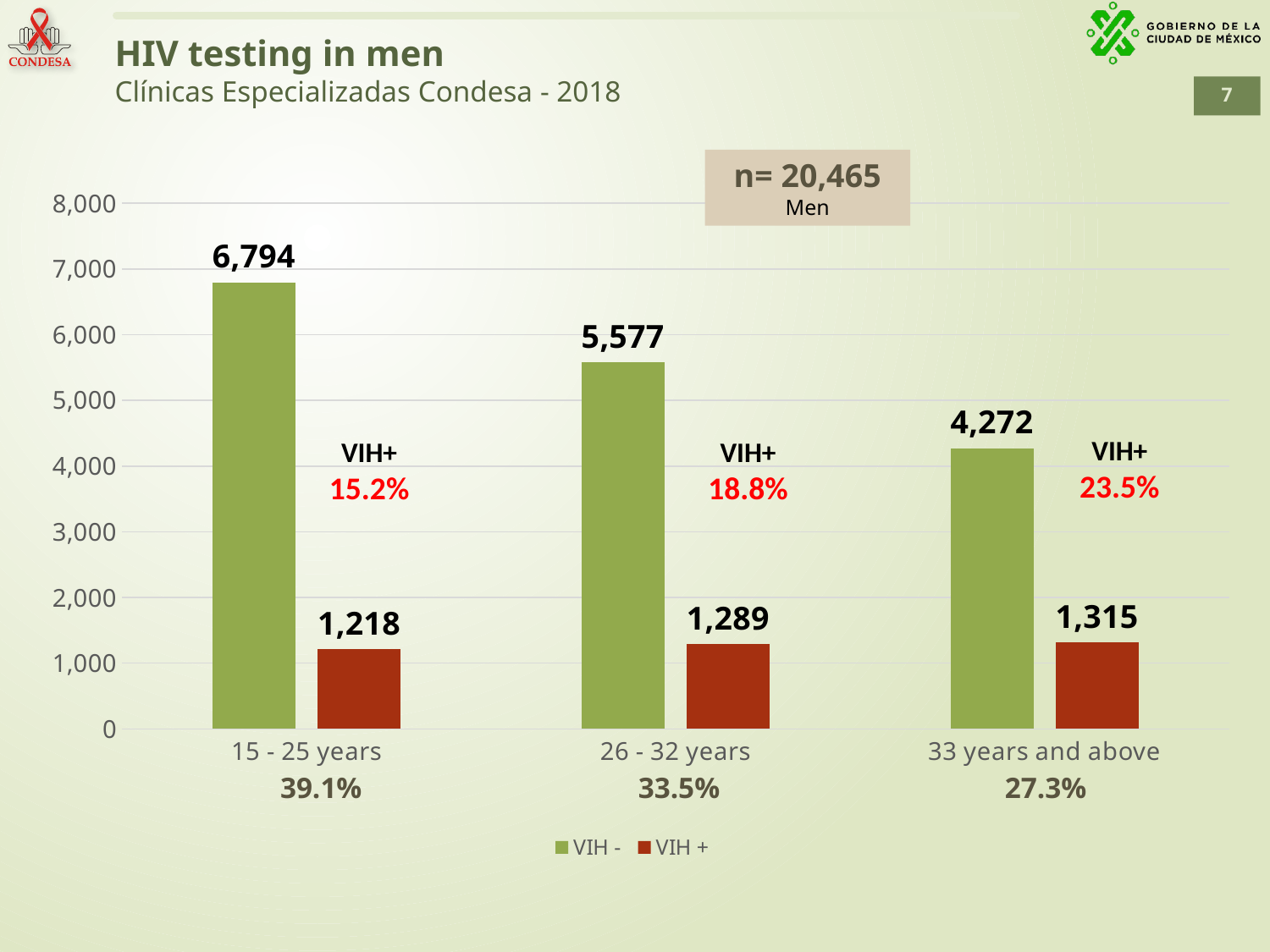
Do the VIH - values rise or fall from the youngest to the oldest age group? fall How many age groups are shown on the x axis? 3 What is the VIH + value for the 26 - 32 years group? 1,289 What kind of chart is shown on the slide? bar chart Which age group has the lowest VIH + value? 15 - 25 years Is the VIH - value for 26 - 32 years greater or less than 5,000? greater Which is larger: the VIH + value for 33 years and above or the VIH + value for 15 - 25 years? 33 years and above What is the VIH - value for the 33 years and above group? 4,272 Which age group has the highest VIH - value? 15 - 25 years How many series does the legend list? 2 What is the VIH - value for the 15 - 25 years group? 6,794 What is the difference between the VIH - values for 15 - 25 years and 26 - 32 years? 1,217